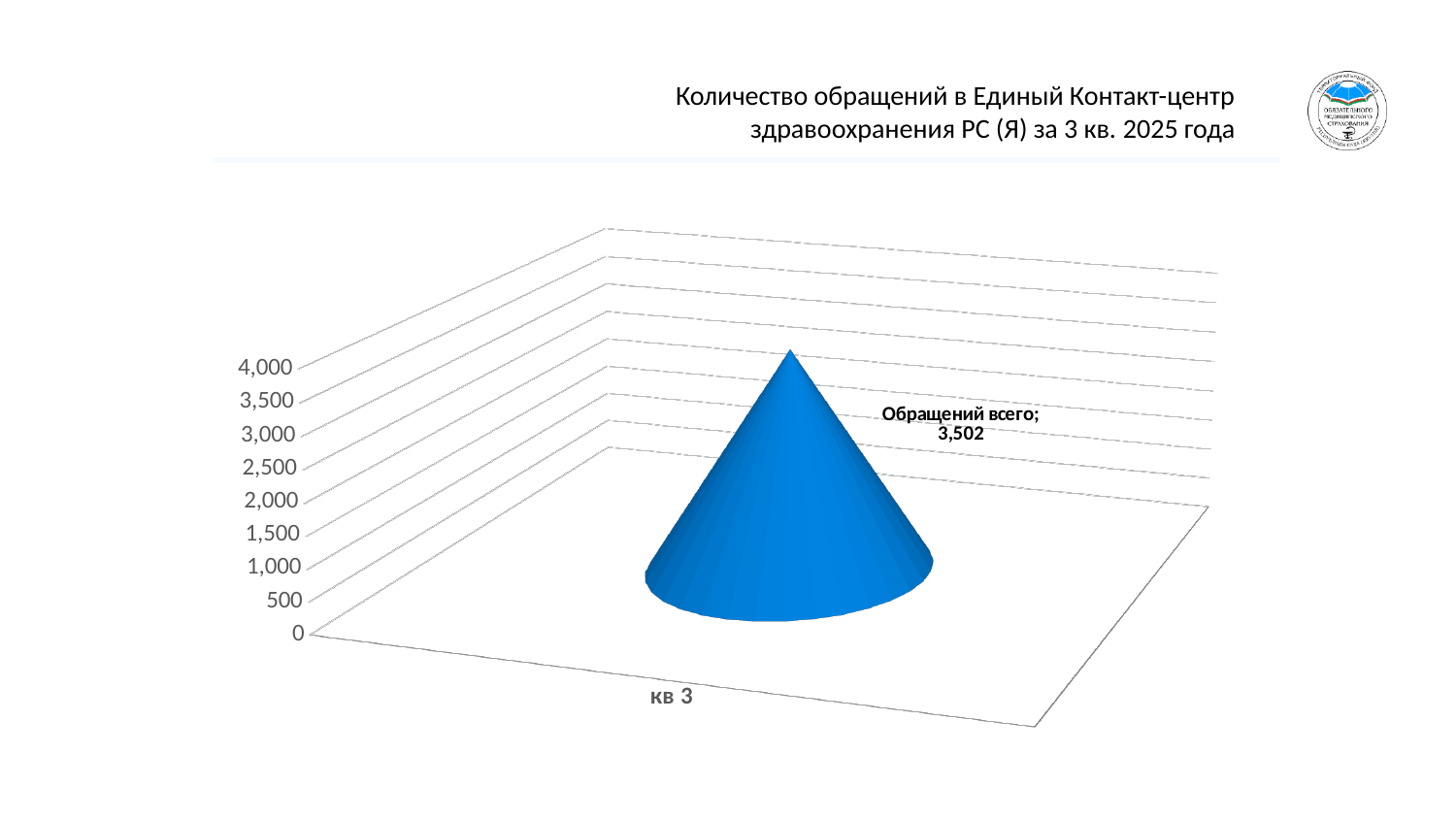
What value is shown for the category "кв 3"? 3,502 Is the value for "Обращений всего" greater or less than 4,000? less What is the label of the single category on the x axis? кв 3 Is the value for "кв 3" greater or less than 3,000? greater What kind of chart is shown on the slide? bar chart What is the value for "Обращений всего" in the chart? 3,502 How many categories are plotted on the x axis of the chart? 1 What is the highest tick value shown on the vertical axis of the chart? 4,000